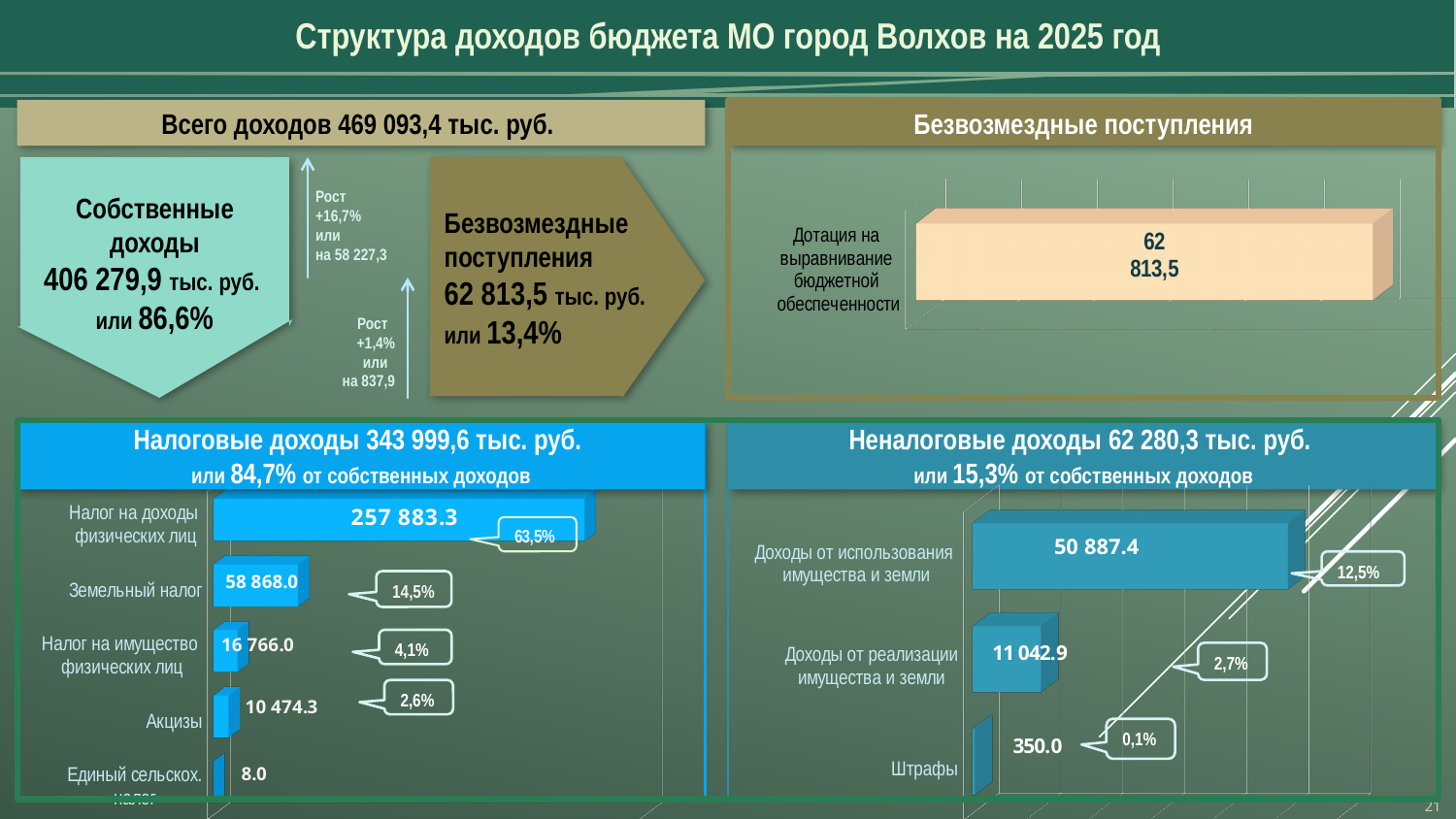
In the 'Неналоговые доходы' chart, what is the value for 'Доходы от использования имущества и земли'? 50 887.4 In the 'Налоговые доходы' chart, how many categories are plotted? 5 What type of chart is the 'Неналоговые доходы' chart? Bar chart In the 'Налоговые доходы' chart, which category has the lowest value? Единый сельскох. налог In the 'Безвозмездные поступления' chart, what is the value for 'Дотация на выравнивание бюджетной обеспеченности'? 62 813,5 In the 'Налоговые доходы' chart, what is the value for 'Земельный налог'? 58 868.0 In the 'Налоговые доходы' chart, what is the difference between 'Налог на доходы физических лиц' and 'Земельный налог'? 199 015.3 In the 'Неналоговые доходы' chart, what is the difference between 'Доходы от использования имущества и земли' and 'Доходы от реализации имущества и земли'? 39 844.5 In the 'Неналоговые доходы' chart, which category has the highest value? Доходы от использования имущества и земли In the 'Налоговые доходы' chart, which is larger: 'Налог на имущество физических лиц' or 'Акцизы'? Налог на имущество физических лиц In the 'Неналоговые доходы' chart, what is the value for 'Штрафы'? 350.0 In the 'Налоговые доходы' chart, what is the value for 'Налог на доходы физических лиц'? 257 883.3